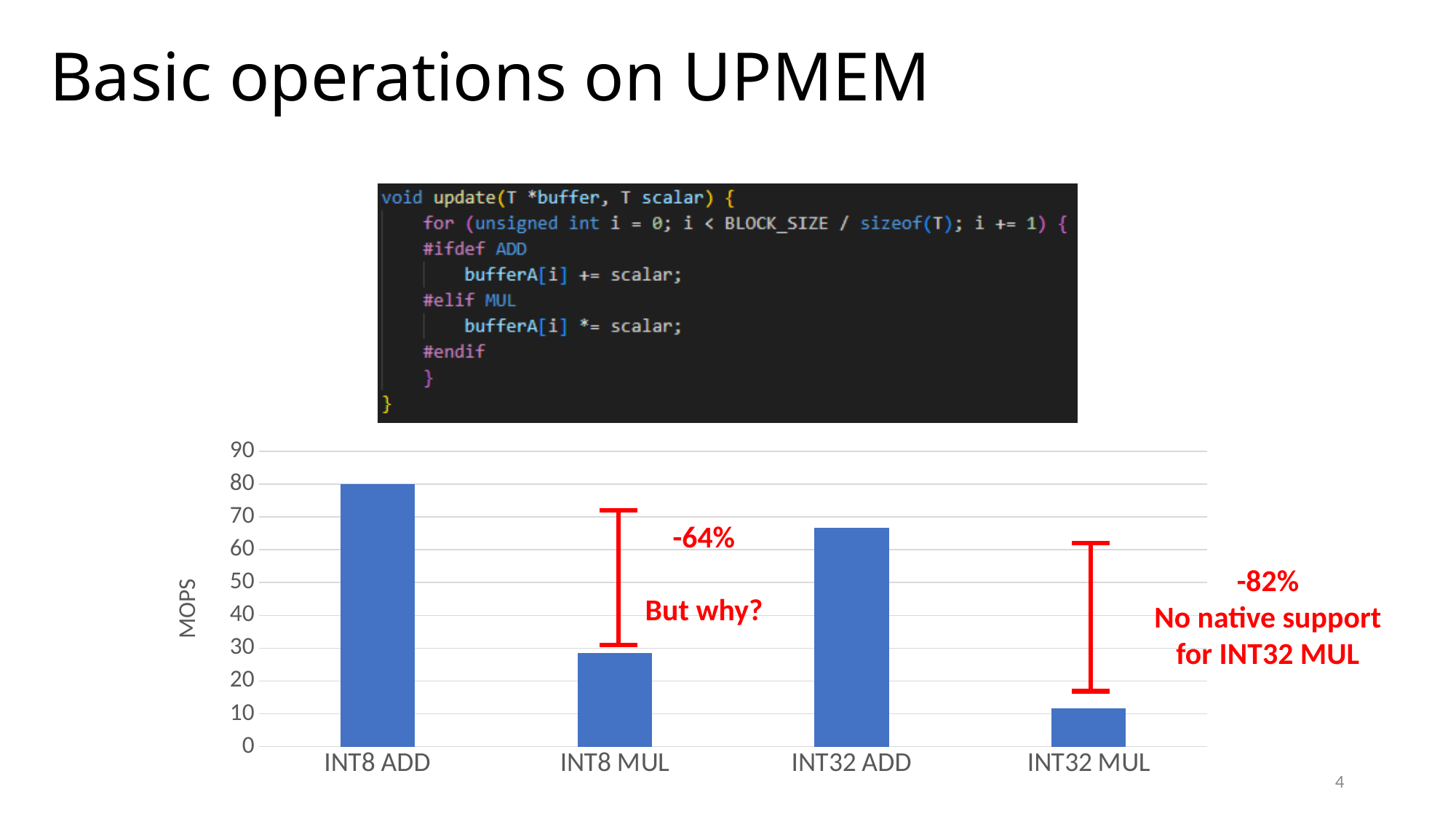
Which category has the lowest value in the chart? INT32 MUL How many categories are plotted on the x axis of the chart? 4 Which is larger, the value for INT8 ADD or the value for INT32 ADD? INT8 ADD Is the value for INT32 ADD greater or less than 60? greater What is the label on the y axis of the chart? MOPS Which is larger, the value for INT8 MUL or the value for INT32 ADD? INT32 ADD Is the value for INT8 ADD greater or less than 70? greater Is the value for INT8 MUL greater or less than 40? less What kind of chart is shown on the slide? bar chart Which category has the highest value in the chart? INT8 ADD What percentage drop is annotated between INT32 ADD and INT32 MUL in the chart? -82%